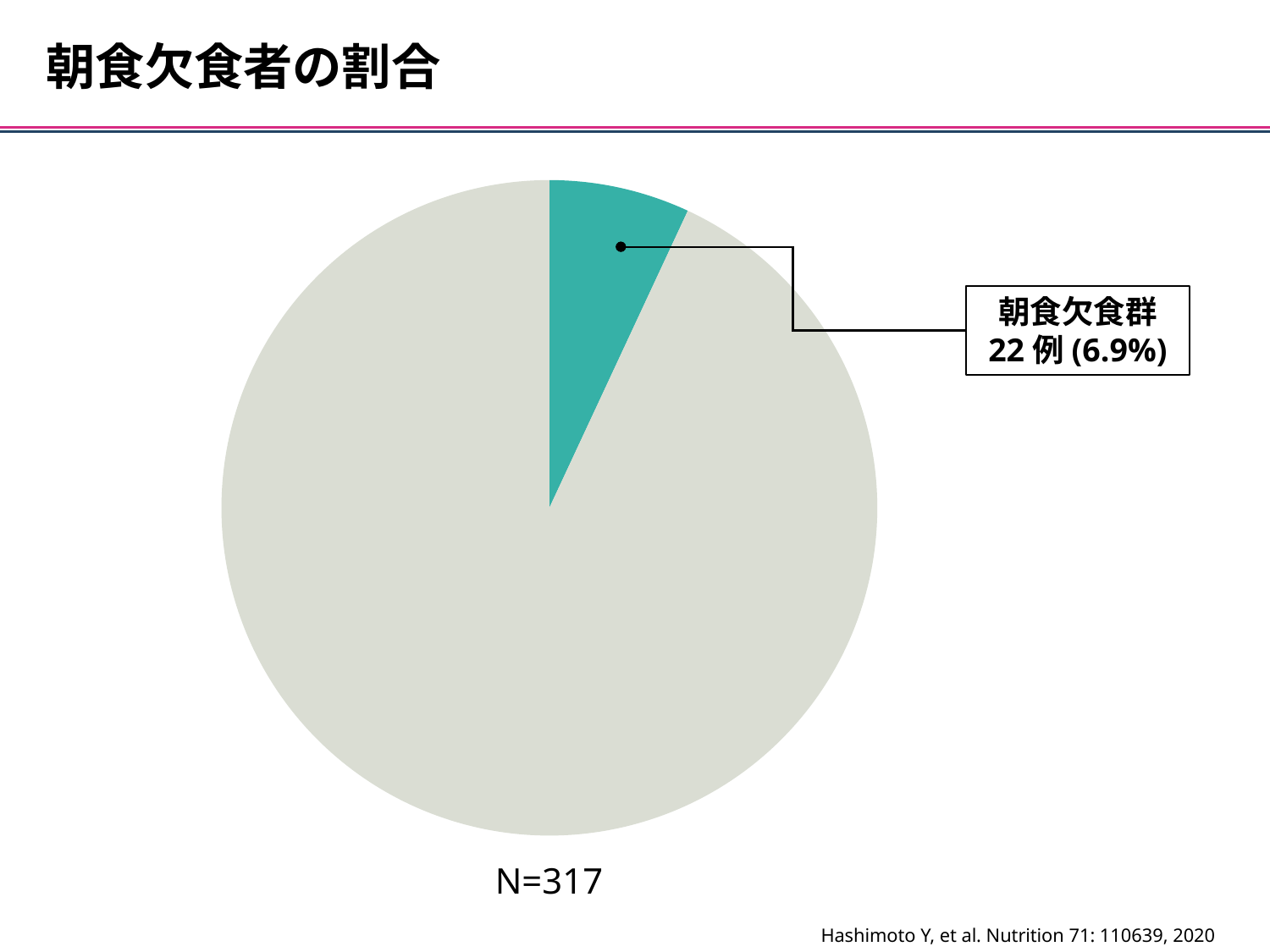
What percentage of the pie is taken by the slice other than 朝食欠食群? 93.1% What is the total N shown below the pie chart? N=317 What percentage of the pie does the 朝食欠食群 slice represent? 6.9% Is the share of the 朝食欠食群 slice greater or less than 10%? Less How many cases (例) are in the 朝食欠食群 group? 22 例 Is the 朝食欠食群 slice the larger or the smaller slice of the pie? Smaller What is the title of the chart on the slide? 朝食欠食者の割合 How many cases are not in the 朝食欠食群 group, given N=317 and 22 cases in the group? 295 How many slices does the pie chart have? 2 What kind of chart is shown on the slide? Pie chart What colour is the 朝食欠食群 slice? Teal (green)